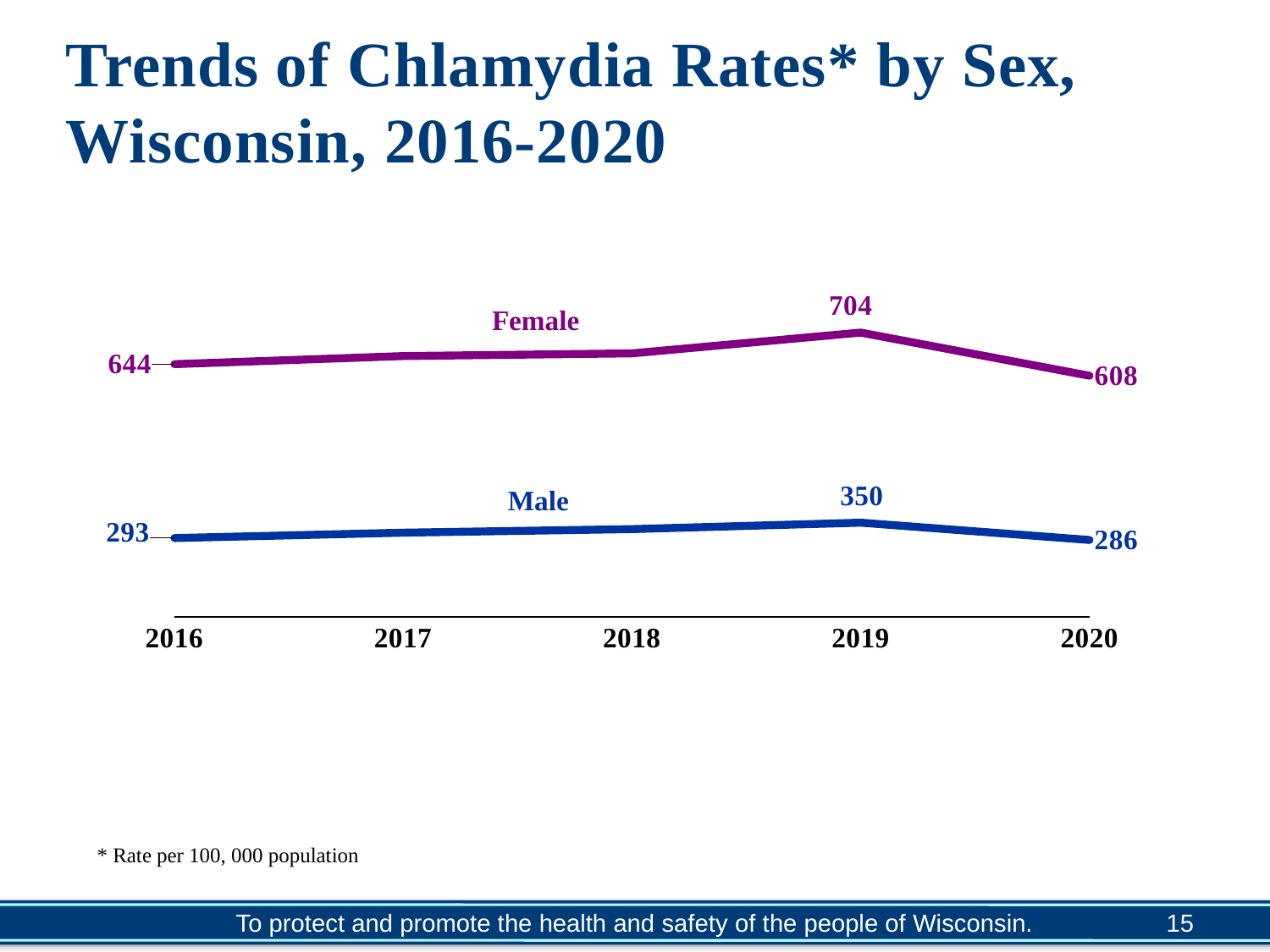
What kind of chart is shown on the slide? Line chart What is the Male chlamydia rate in 2020? 286 What is the Male chlamydia rate in 2016? 293 In which year is the Male rate highest? 2019 How many years are shown on the x axis? 5 What is the difference between the Female and Male rates in 2016? 351 What is the Female chlamydia rate in 2019? 704 Which is larger, the Male rate in 2019 or the Male rate in 2016? Male rate in 2019 What is the Female chlamydia rate in 2020? 608 How many series are plotted on the chart? 2 What is the difference between the Female rate in 2019 and the Female rate in 2020? 96 In which year is the Female rate highest? 2019